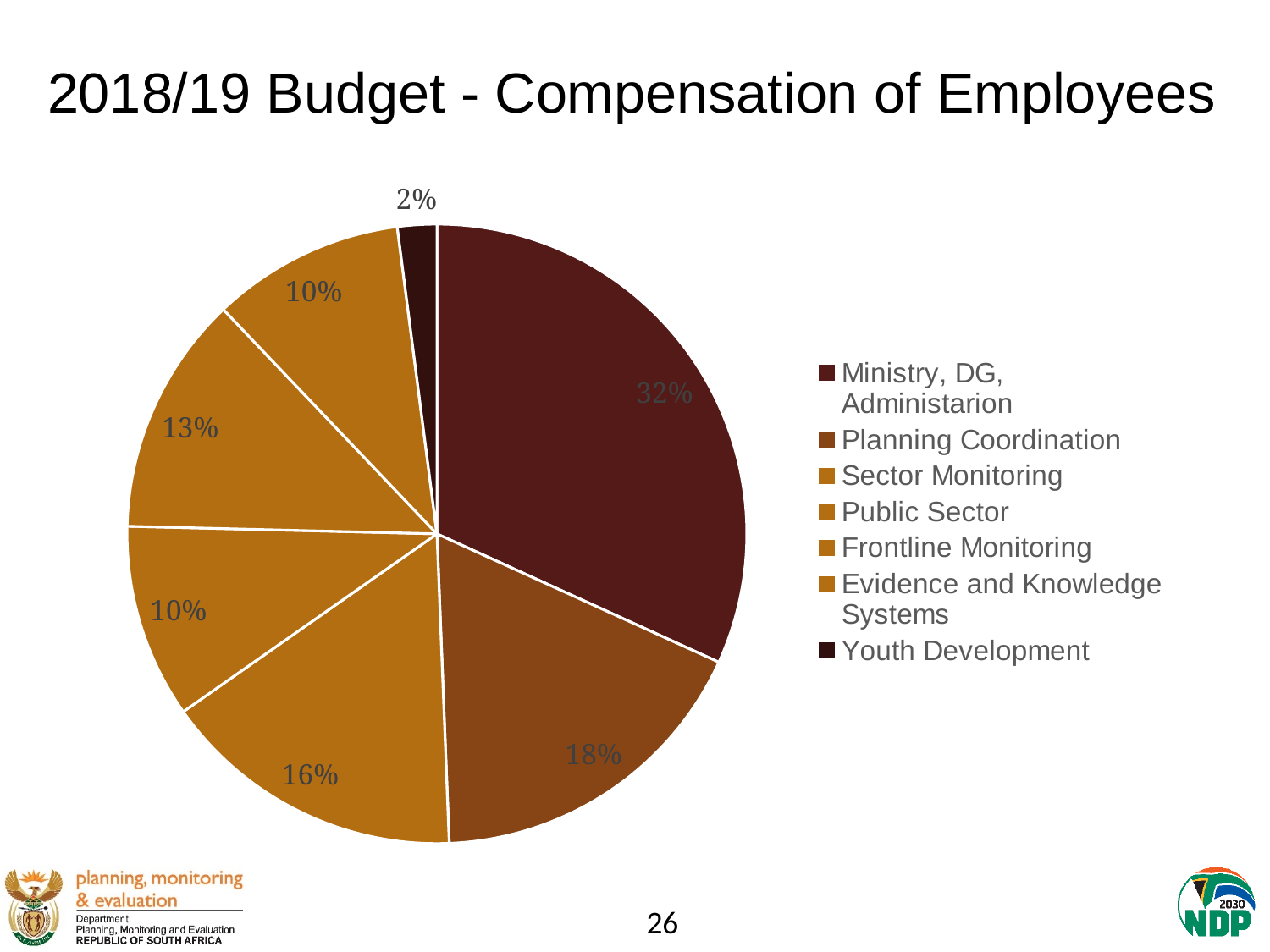
What is the difference in percentage points between the Ministry, DG, Administration slice and the Planning Coordination slice? 14 What percentage is shown for Sector Monitoring? 16% How many categories does the legend list? 7 Which category has the largest slice of the pie? Ministry, DG, Administration What percentage is shown for Frontline Monitoring? 13% What share does Youth Development have in the pie chart? 2% What percentage of the pie is Planning Coordination? 18% What kind of chart is shown on the slide? pie chart Which category has the smallest slice of the pie? Youth Development What share of the pie is Public Sector? 10% What share of the 2018/19 compensation of employees budget goes to Ministry, DG, Administration? 32% Which is larger, the Sector Monitoring slice or the Frontline Monitoring slice? Sector Monitoring